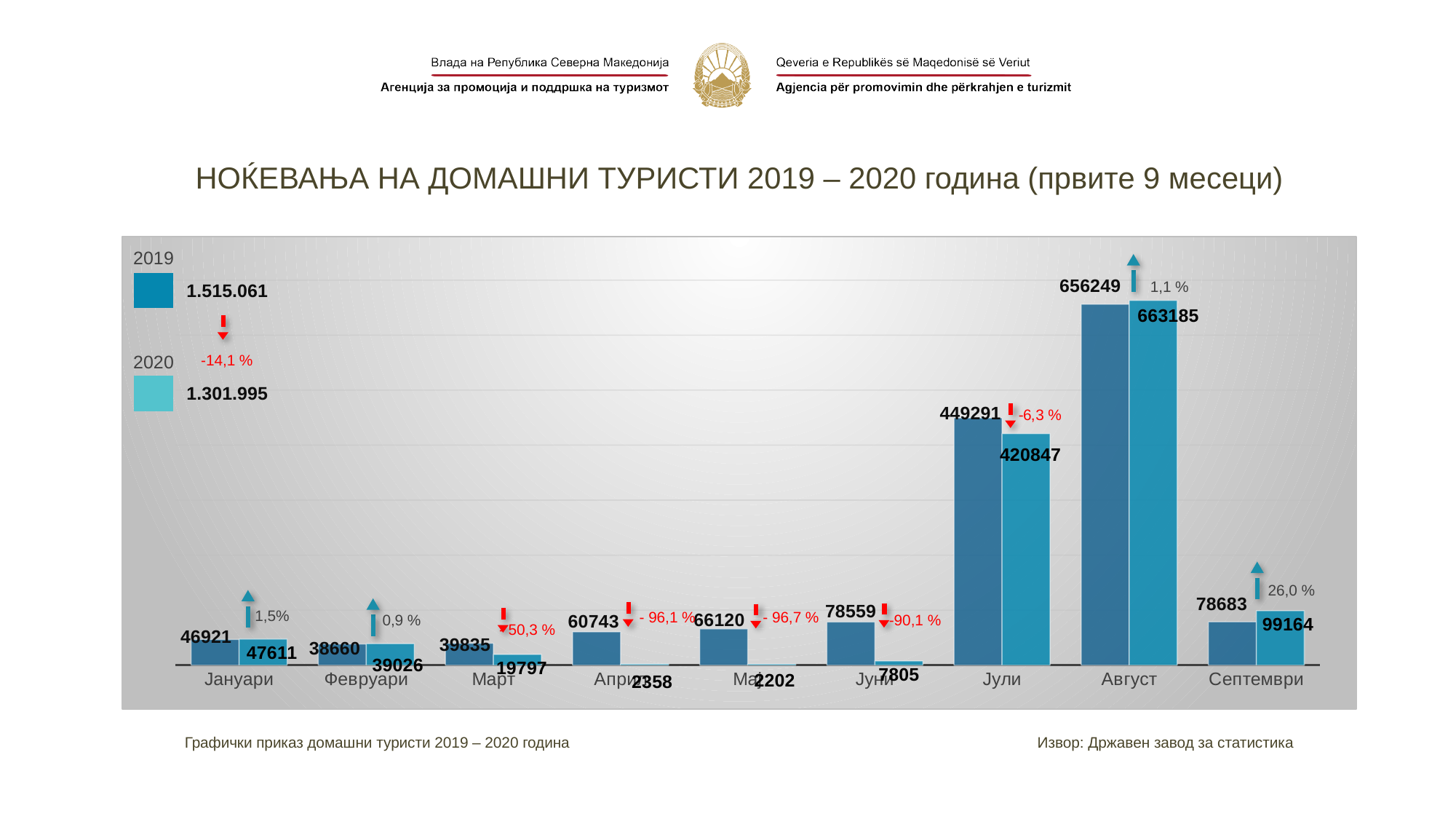
What percentage change is shown next to the legend between the 2019 and 2020 totals? -14,1 % What is the value for 2020 in Јули (July)? 420847 Which month has the highest value for 2019? Август Which month has the lowest value for 2020? Мај What is the value for 2020 in Април (April)? 2358 What is the difference between the 2019 and 2020 values in Јули (July)? 28444 Which is larger in Септември (September): the 2019 value or the 2020 value? 2020 What kind of chart is shown on the slide? bar chart What is the value for 2019 in Август (August)? 656249 How many series does the legend list? 2 What total is shown in the legend for 2020? 1.301.995 How many months are shown on the x axis? 9